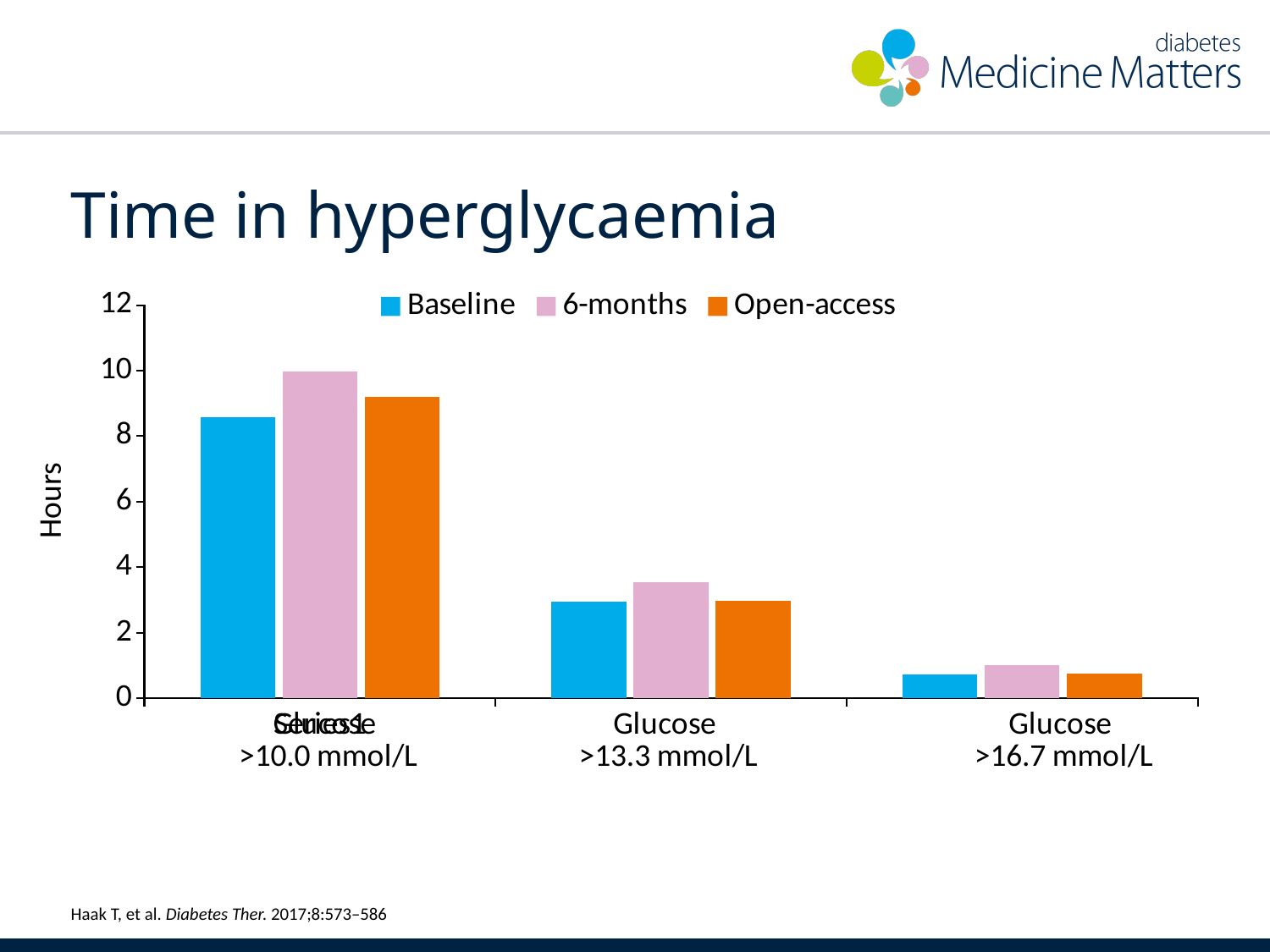
Is the 6-months value for Glucose >16.7 mmol/L greater or less than 2? less What kind of chart is shown on the slide? Bar chart For Glucose >10.0 mmol/L, which is larger: the Baseline value or the 6-months value? 6-months What is the label of the y axis? Hours What is the title of the chart? Time in hyperglycaemia Is the 6-months value for Glucose >13.3 mmol/L greater or less than 4? less Is the Baseline value for Glucose >10.0 mmol/L greater or less than 8? greater Which glucose category has the lowest values across all series? Glucose >16.7 mmol/L Which series has the highest value for Glucose >13.3 mmol/L? 6-months How many series does the legend list? 3 How many glucose threshold categories are shown on the x axis? 3